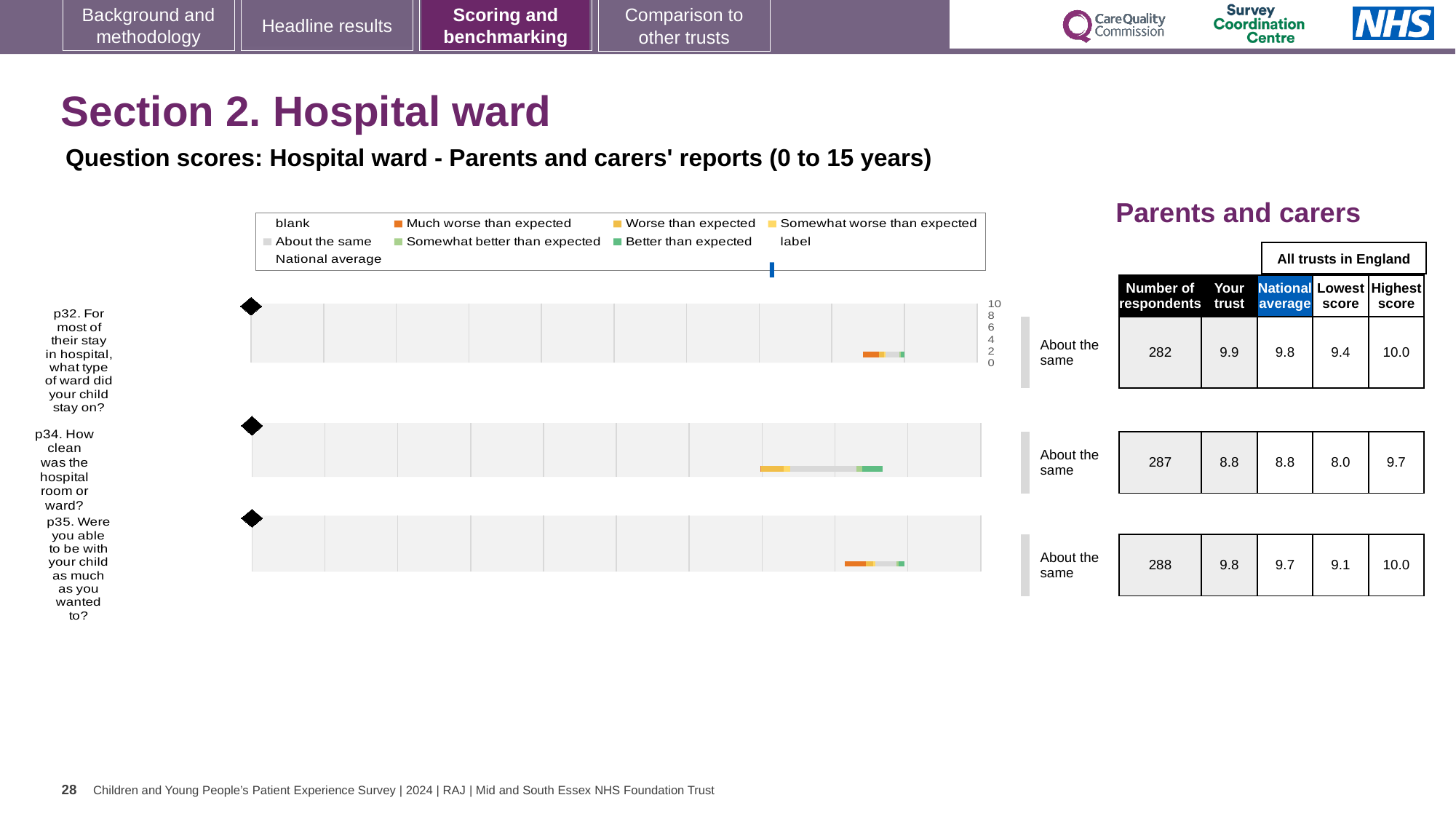
What is the difference between the highest score and the lowest score for p34? 1.7 What is the national average score for p35 (were you able to be with your child as much as you wanted to)? 9.7 How many questions are plotted as bars in the chart? 3 What is the number of respondents for p32 (what type of ward did your child stay on)? 282 What benchmark category is shown next to all three questions? About the same For p32, which is larger: the 'Your trust' score or the national average? Your trust What kind of chart is used to show the question scores? bar chart What is the 'Your trust' score for p34 (how clean was the hospital room or ward)? 8.8 Which question has the lowest 'Your trust' score? p34 What is the highest score among all trusts in England for p34? 9.7 What is the lowest score among all trusts in England for p32? 9.4 Which question has the highest 'Your trust' score? p32